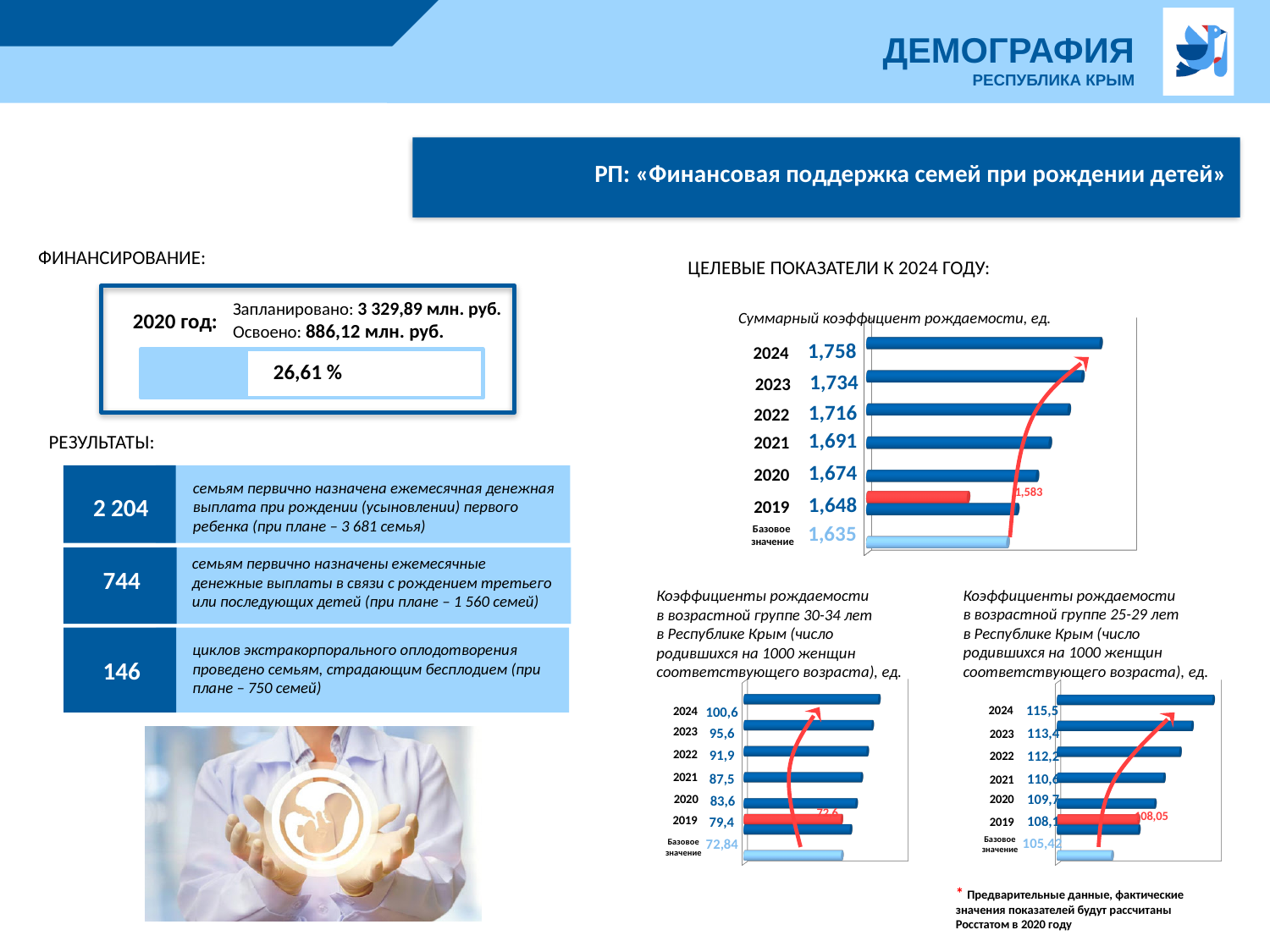
In the chart 'Суммарный коэффициент рождаемости, ед.', what is the value for 2024? 1,758 In the chart for the age group 25-29 лет, what is the difference between the values for 2024 and 2023? 2,1 What kind of chart is used for 'Суммарный коэффициент рождаемости, ед.'? Bar chart In the chart for the age group 30-34 лет, do the values rise or fall from 2019 to 2024? Rise In the chart for the age group 30-34 лет, what is the value for 2021? 87,5 In the chart for the age group 25-29 лет, which is larger: the value for 2022 or the value for 2019? 2022 In the chart 'Суммарный коэффициент рождаемости, ед.', which category has the highest value? 2024 In the chart 'Суммарный коэффициент рождаемости, ед.', what is the difference between the values for 2024 and 2023? 0,024 In the chart 'Суммарный коэффициент рождаемости, ед.', what is the value for 'Базовое значение'? 1,635 In the chart for the age group 30-34 лет, what is the value for 'Базовое значение'? 72,84 In the chart for the age group 25-29 лет, what is the value for 2020? 109,7